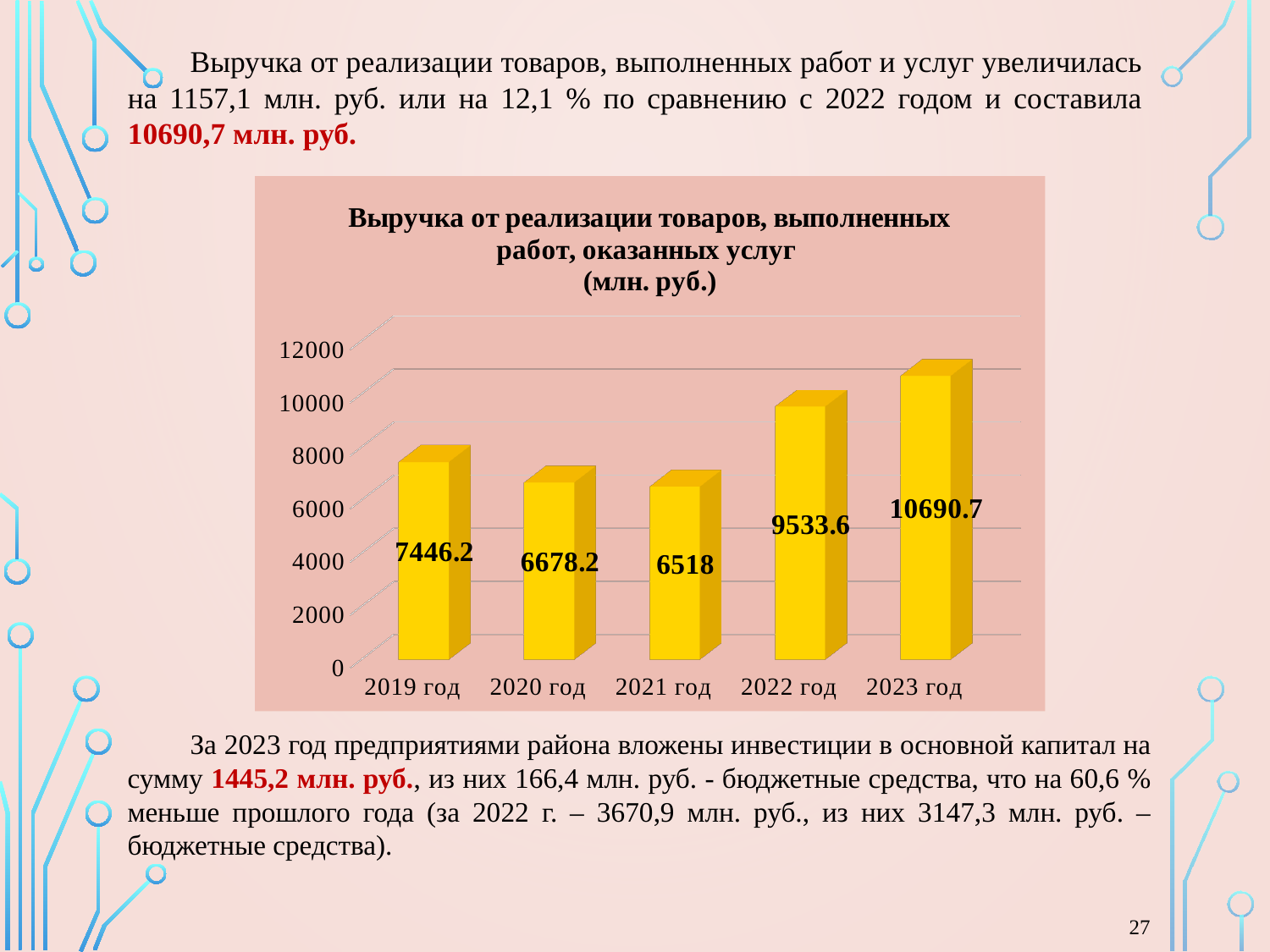
What is the difference between the values for 2019 год and 2020 год? 768 Which year has the highest value in the chart? 2023 год What is the value for 2021 год in the chart? 6518 What kind of chart is shown on the slide? bar chart What is the value for 2023 год in the chart? 10690.7 Is the value for 2022 год greater or less than 8000? greater What is the value for 2019 год in the chart? 7446.2 How many years are shown in the chart? 5 What is the difference between the values for 2023 год and 2022 год? 1157.1 Which year has the lowest value in the chart? 2021 год What unit is given in the chart title? млн. руб. Which is larger, the value for 2019 год or the value for 2020 год? 2019 год